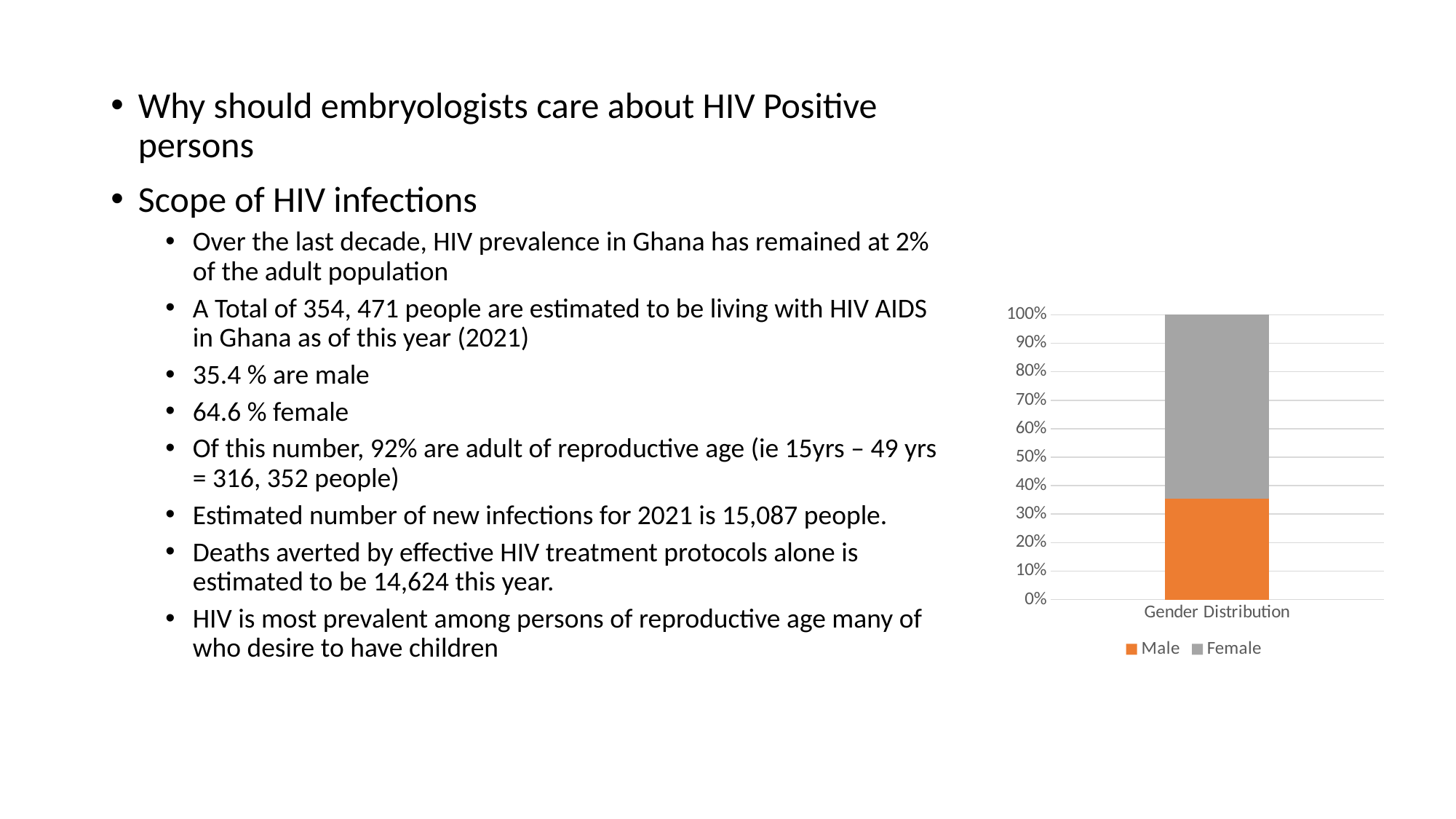
What is the label of the category on the x axis of the chart? Gender Distribution Which series takes up the larger share of the Gender Distribution bar, Male or Female? Female Is the value for Male in the Gender Distribution bar greater or less than 40%? less How many categories are plotted on the x axis of the chart? 1 What kind of chart is shown on the slide? Stacked bar chart What is the total height of the stacked Gender Distribution bar? 100% How many series does the chart legend list? 2 Is the value for Female in the Gender Distribution bar greater or less than 60%? greater Which colour represents the Male series in the chart? Orange Which series has the smallest segment in the Gender Distribution bar? Male Is the value for Male in the Gender Distribution bar greater or less than 30%? greater Which series has the largest segment in the Gender Distribution bar? Female